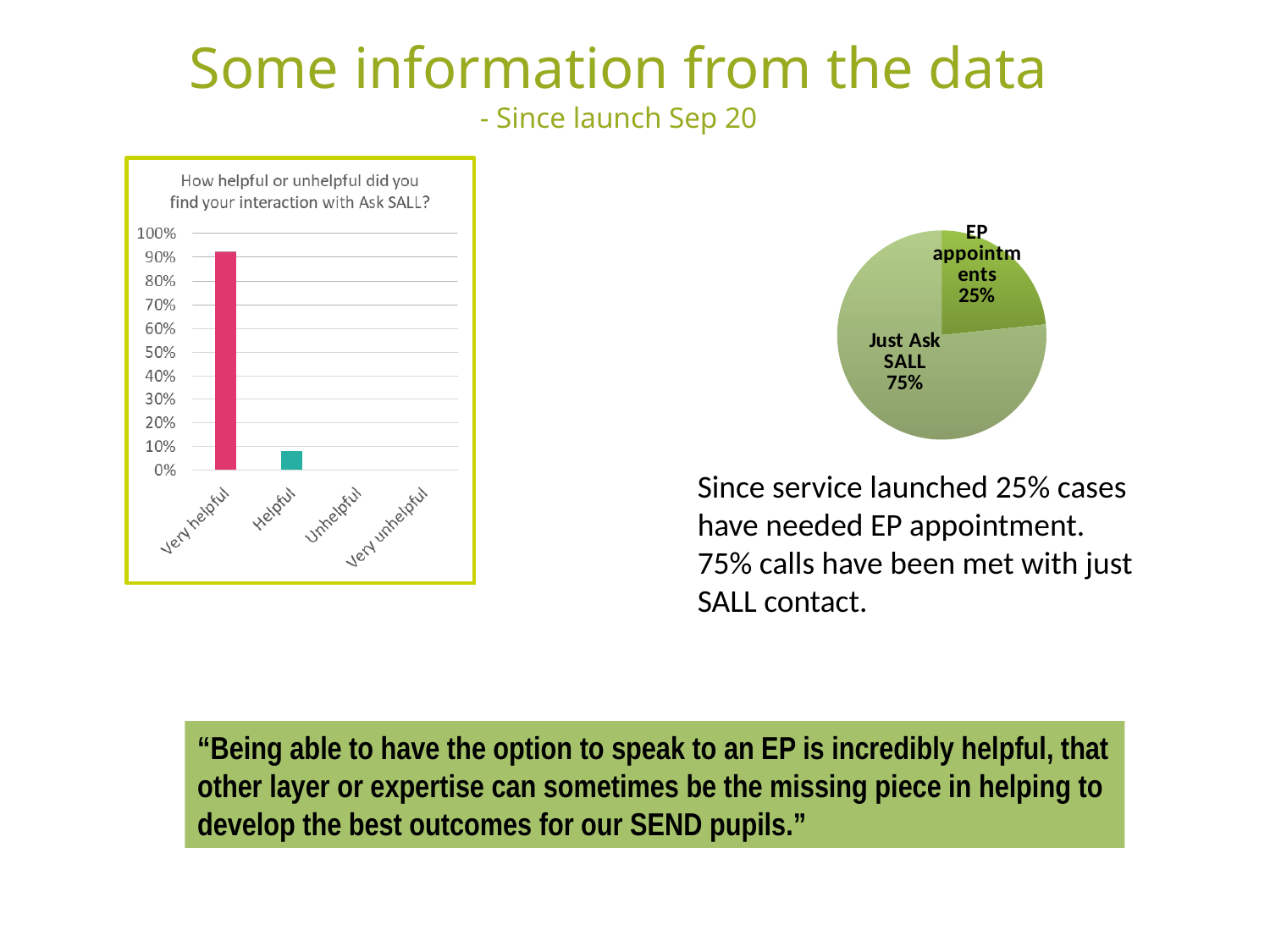
In the bar chart on the left, which is larger, the value for Very helpful or the value for Helpful? Very helpful In the bar chart on the left, what kind of chart is it? bar chart In the bar chart on the left, what is the question shown as the chart title? How helpful or unhelpful did you find your interaction with Ask SALL? In the pie chart on the right, what percentage of cases needed EP appointments? 25% In the bar chart on the left, is the value for Very helpful greater or less than 80%? greater In the bar chart on the left, which category has the highest value? Very helpful In the pie chart on the right, what is the difference between the Just Ask SALL share and the EP appointments share? 50% In the pie chart on the right, how many slices does the pie have? 2 In the pie chart on the right, which slice is larger, EP appointments or Just Ask SALL? Just Ask SALL In the pie chart on the right, what share of the pie is Just Ask SALL? 75% In the bar chart on the left, is the value for Helpful greater or less than 20%? less In the bar chart on the left, how many response categories are shown on the x axis? 4